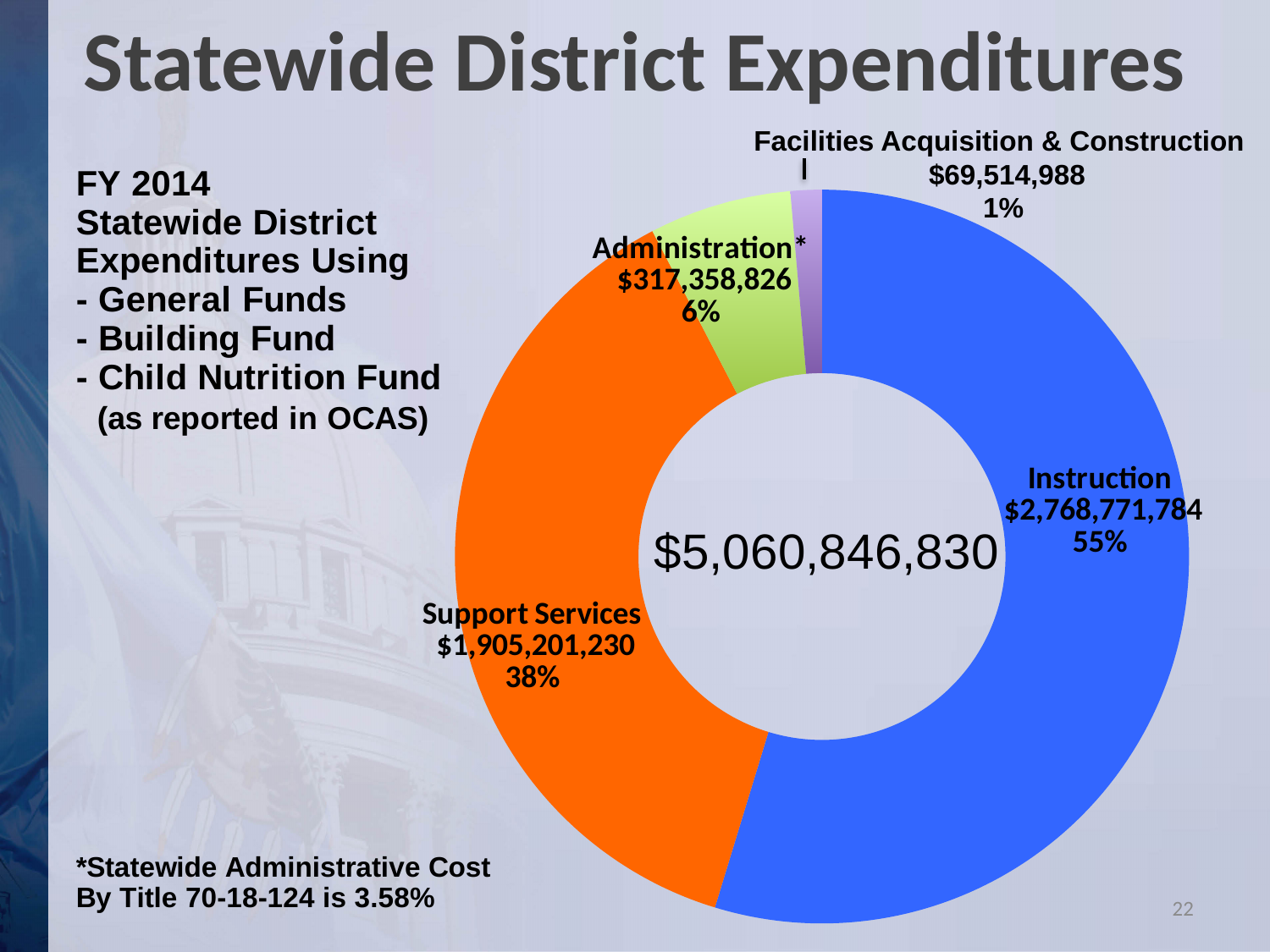
Which category has the smallest share of expenditures? Facilities Acquisition & Construction Which category has the largest share of expenditures? Instruction What is the expenditure value for Support Services? $1,905,201,230 Which is larger, the expenditure for Administration* or for Facilities Acquisition & Construction? Administration* What is the expenditure value for Facilities Acquisition & Construction? $69,514,988 What total amount is shown in the center of the chart? $5,060,846,830 What percentage share of expenditures does Administration* represent? 6% What is the difference between the Instruction and Support Services expenditures? $863,570,554 What is the expenditure value for Instruction? $2,768,771,784 What is the expenditure value for Administration*? $317,358,826 What percentage share of expenditures does Support Services represent? 38% How many categories are shown in the chart? 4